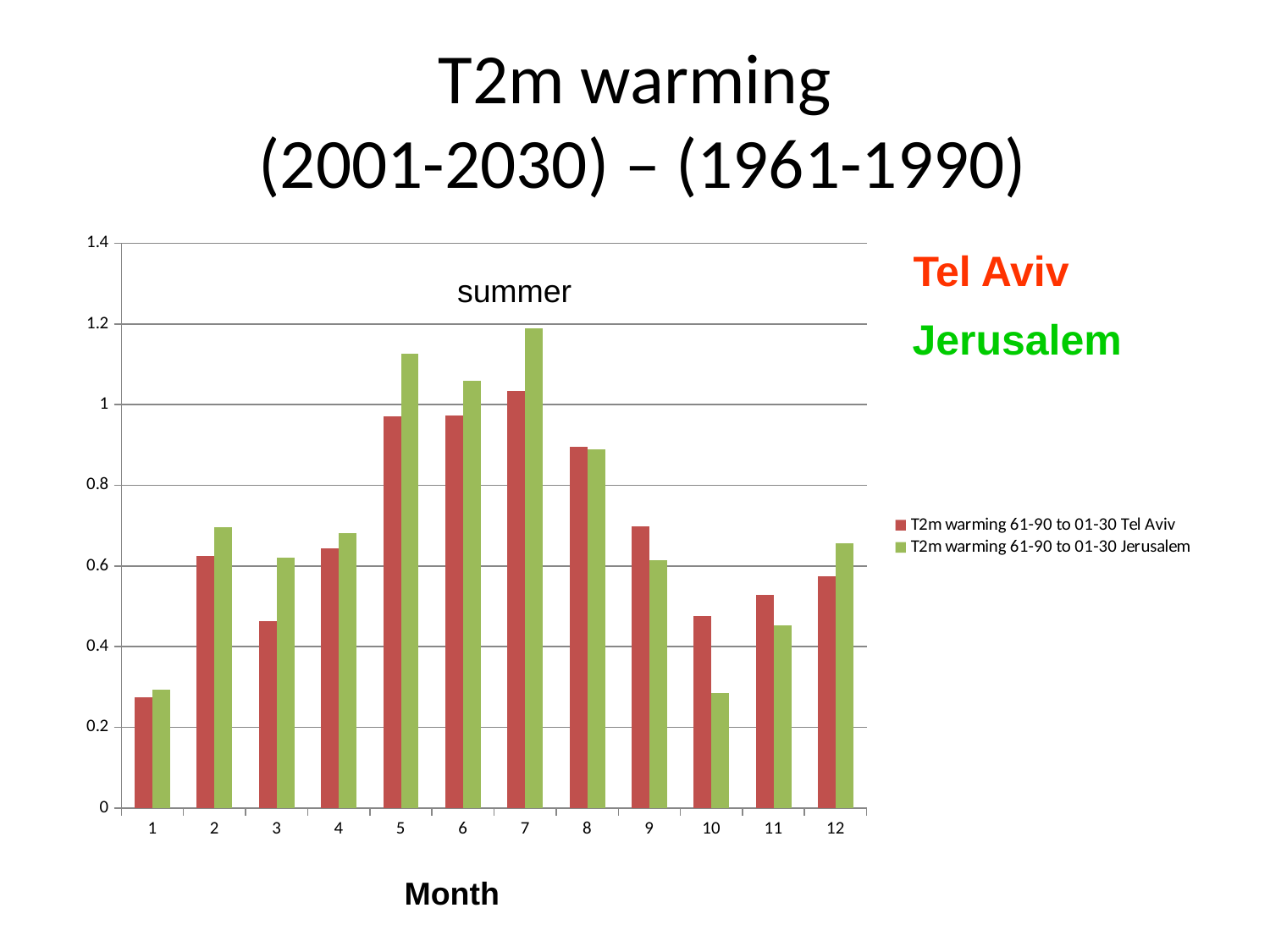
What kind of chart is shown on the slide? bar chart How many months are shown along the x axis of the chart? 12 In month 3, which series has the larger value, Tel Aviv or Jerusalem? Jerusalem Do the Tel Aviv values rise or fall from month 7 to month 10? fall In which month is the Jerusalem T2m warming value highest? 7 How many series does the chart's legend list? 2 In month 10, which series has the larger value, Tel Aviv or Jerusalem? Tel Aviv In which month is the Tel Aviv T2m warming value highest? 7 Is the Tel Aviv value for month 10 greater or less than 0.6? less In which month is the Tel Aviv T2m warming value lowest? 1 Is the Jerusalem value for month 5 greater or less than 1? greater Is the Jerusalem value for month 10 greater or less than 0.4? less